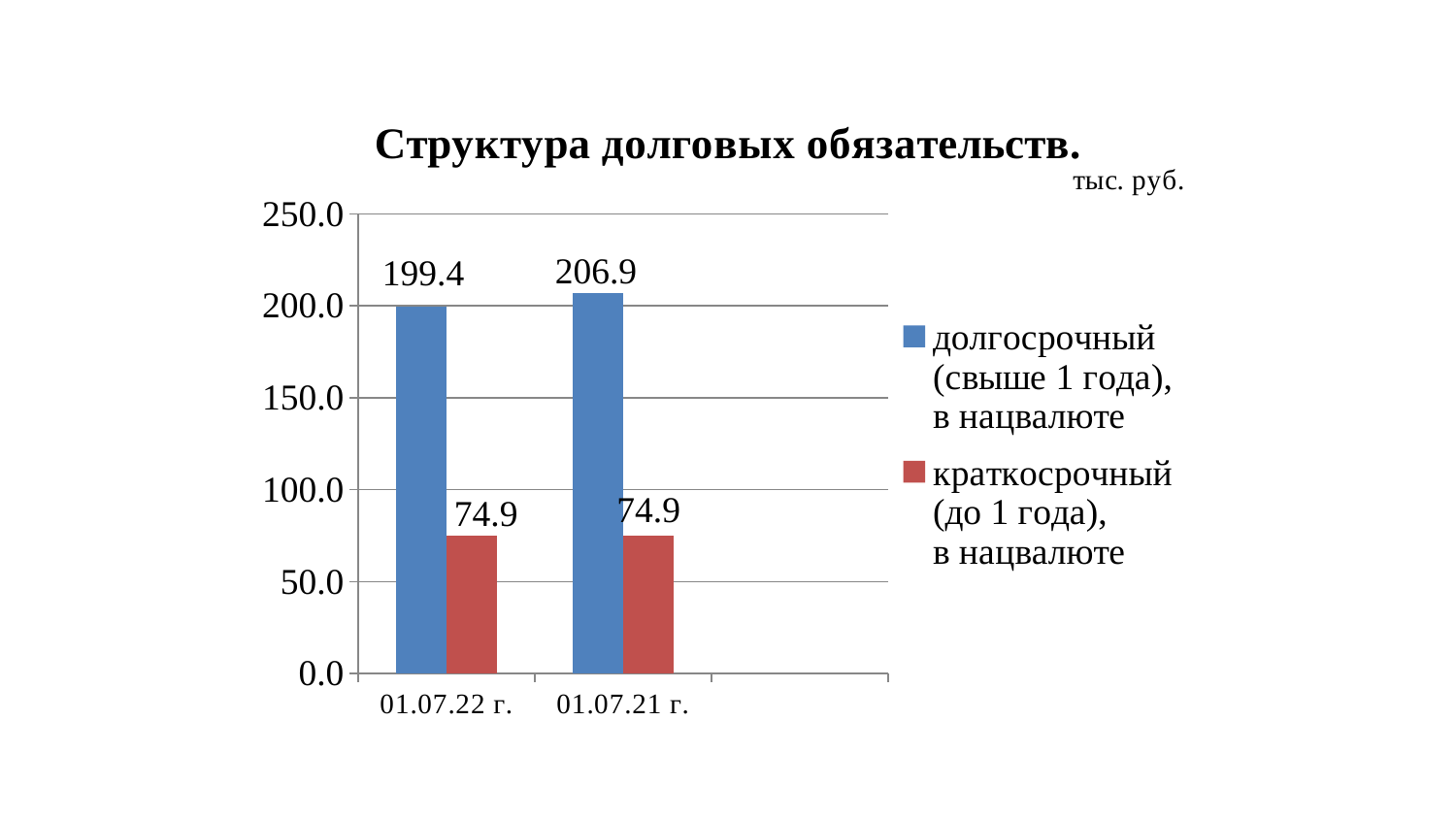
What is the value of краткосрочный (до 1 года), в нацвалюте for 01.07.22 г.? 74.9 What is the value of долгосрочный (свыше 1 года), в нацвалюте for 01.07.21 г.? 206.9 What is the difference between the долгосрочный values for 01.07.21 г. and 01.07.22 г.? 7.5 What type of chart is shown on the slide? bar chart Which is larger for 01.07.21 г.: долгосрочный or краткосрочный? долгосрочный What is the value of долгосрочный (свыше 1 года), в нацвалюте for 01.07.22 г.? 199.4 Is the value for долгосрочный on 01.07.22 г. greater or less than 150.0? greater What is the value of краткосрочный (до 1 года), в нацвалюте for 01.07.21 г.? 74.9 How many categories are shown on the x axis? 2 Which date has the higher value for долгосрочный (свыше 1 года), в нацвалюте? 01.07.21 г. What is the difference between the долгосрочный and краткосрочный values for 01.07.22 г.? 124.5 How many series does the legend list? 2